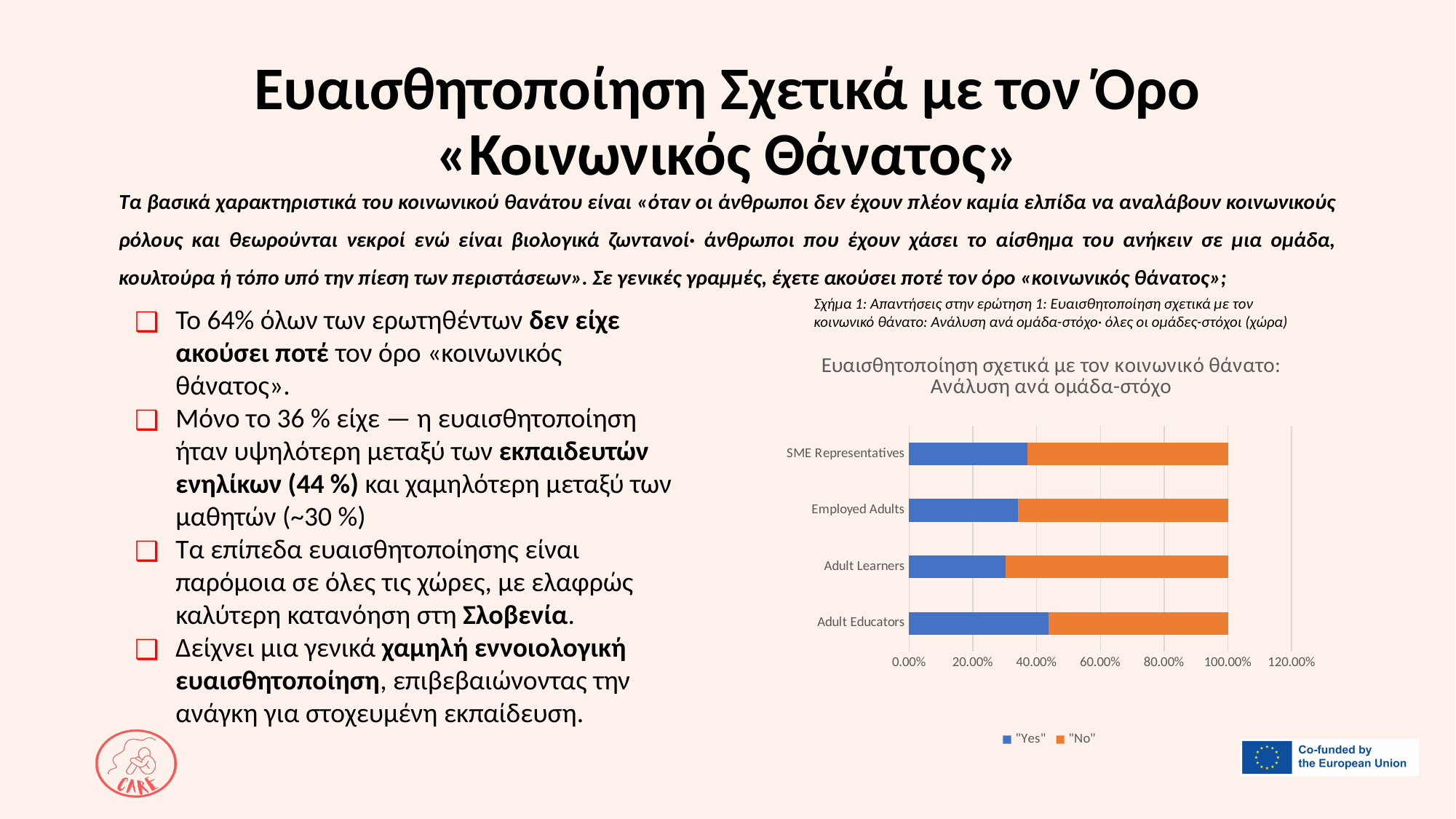
How many series does the chart legend list? 2 Which group has a larger "Yes" share: Adult Educators or SME Representatives? Adult Educators What is the total of the stacked bar for Employed Adults? 100.00% Which target group has the smallest "Yes" share on the chart? Adult Learners Is the "Yes" value for Adult Educators greater or less than 40.00%? greater Is the "Yes" value for Adult Learners greater or less than 40.00%? less Which target group has the largest "Yes" share on the chart? Adult Educators How many target groups (categories) are shown on the chart? 4 Which is larger for Adult Learners: the "Yes" share or the "No" share? "No" Which colour represents the "No" series in the chart? orange Is the "Yes" value for Employed Adults greater or less than 40.00%? less What kind of chart is shown on the slide? bar chart